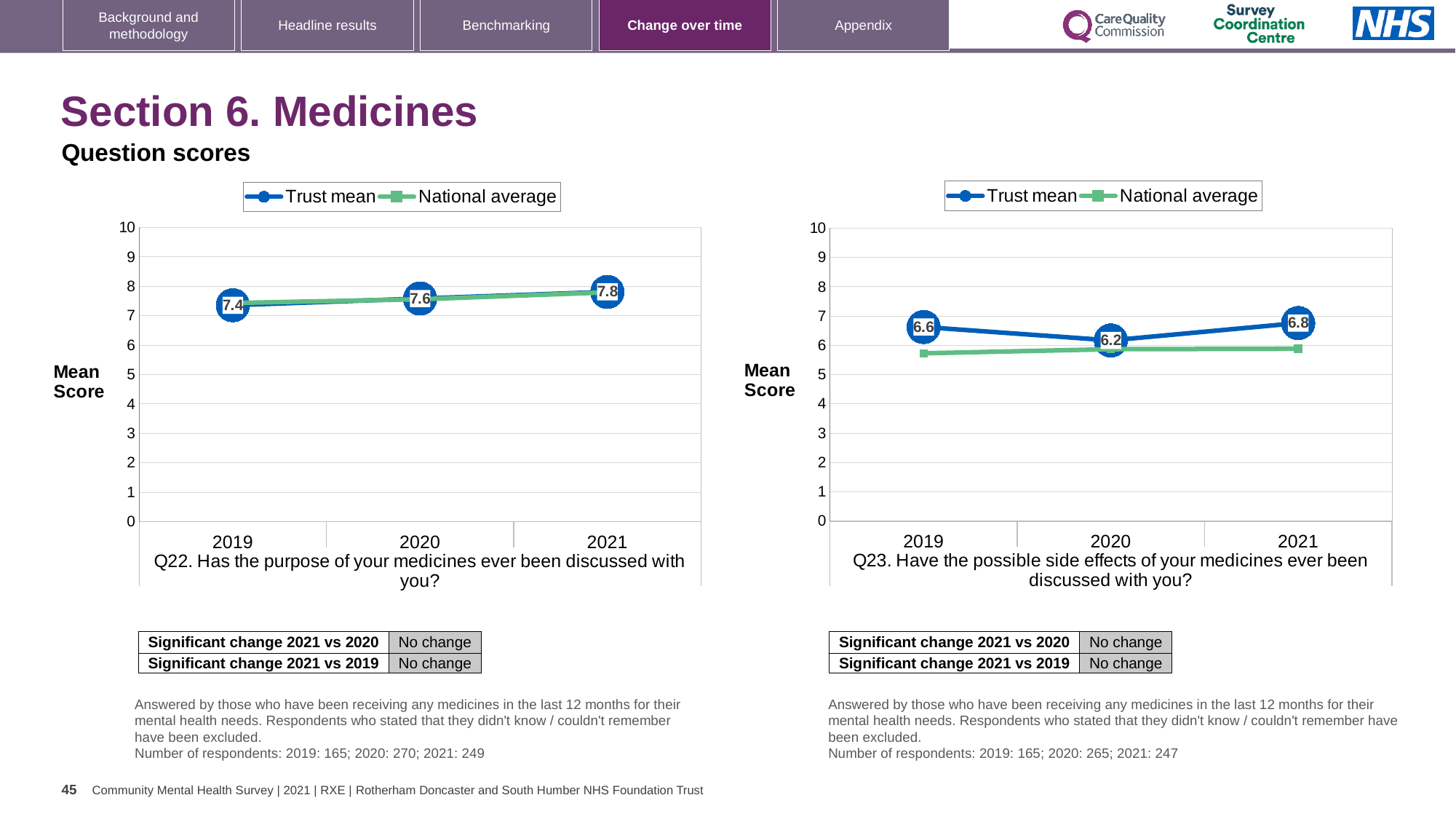
In the Q23 chart on the right, is the National average for 2019 greater or less than 5? greater In the Q22 chart on the left, what is the Trust mean for 2021? 7.8 In the Q23 chart on the right, what is the Trust mean for 2020? 6.2 In the Q23 chart on the right, is the Trust mean for 2021 greater or less than the National average for 2021? greater What kind of chart is the Q23 chart on the right? line chart In the Q22 chart on the left, does the Trust mean rise or fall from 2019 to 2021? rise In the Q22 chart on the left, what is the difference between the Trust mean for 2021 and the Trust mean for 2019? 0.4 In the Q23 chart on the right, which year has the lowest Trust mean? 2020 In the Q23 chart on the right, which year has the highest Trust mean? 2021 How many series does the legend of the Q22 chart on the left list? 2 In the Q22 chart on the left, what is the Trust mean for 2019? 7.4 In the Q23 chart on the right, what is the difference between the Trust mean for 2021 and the Trust mean for 2020? 0.6